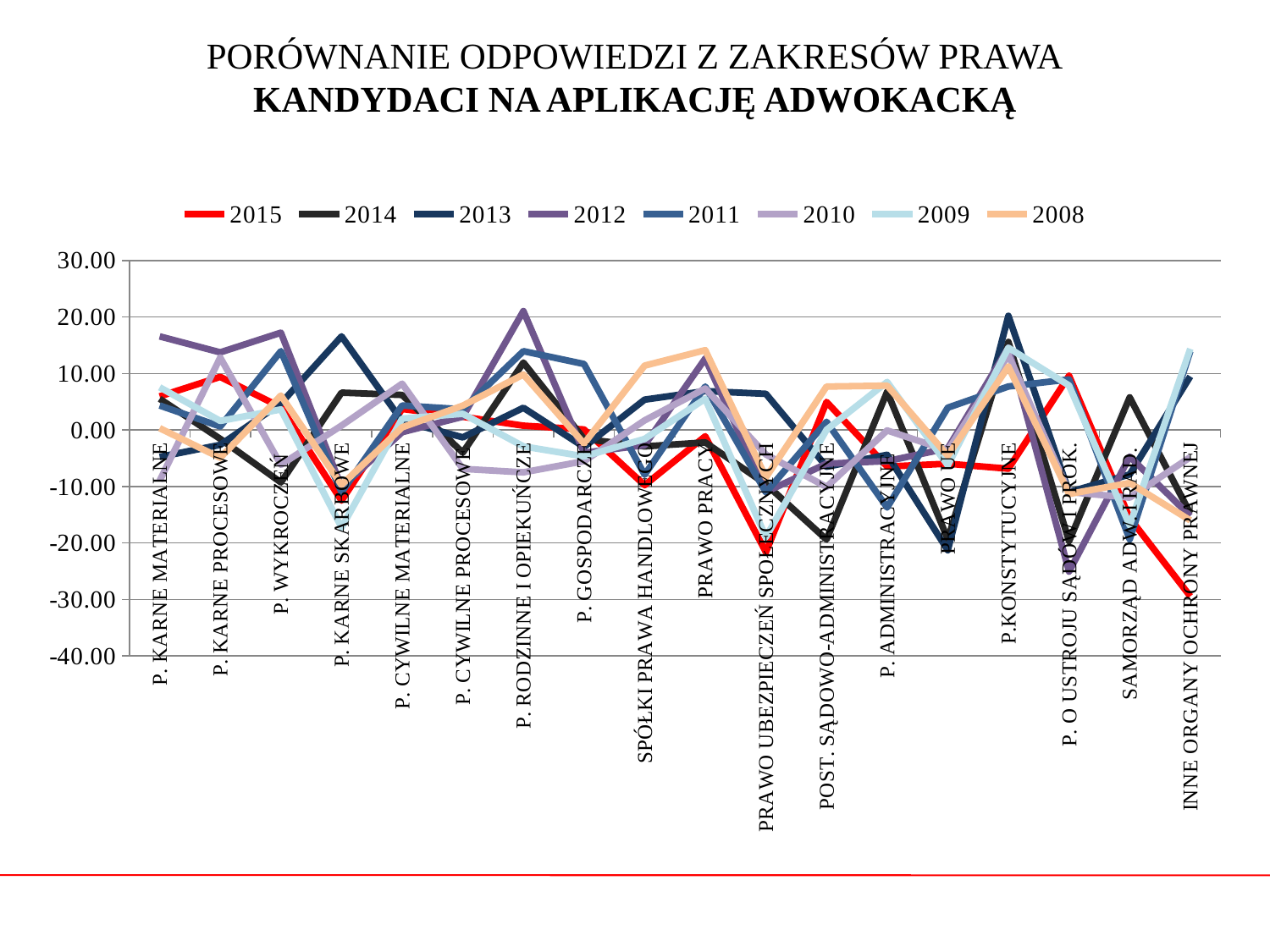
Is the 2012 value for P. RODZINNE I OPIEKUŃCZE greater or less than 10? greater Is the 2013 value for P. KONSTYTUCYJNE greater or less than 10? greater How many series does the legend list? 8 What kind of chart is shown on the slide? line chart What colour is the line for 2015? red For the 2015 series, which category has the lowest value? INNE ORGANY OCHRONY PRAWNEJ Is the 2013 value for P. KARNE SKARBOWE greater or less than 10? greater How many categories are plotted along the x axis? 18 Which years are listed in the legend? 2015, 2014, 2013, 2012, 2011, 2010, 2009, 2008